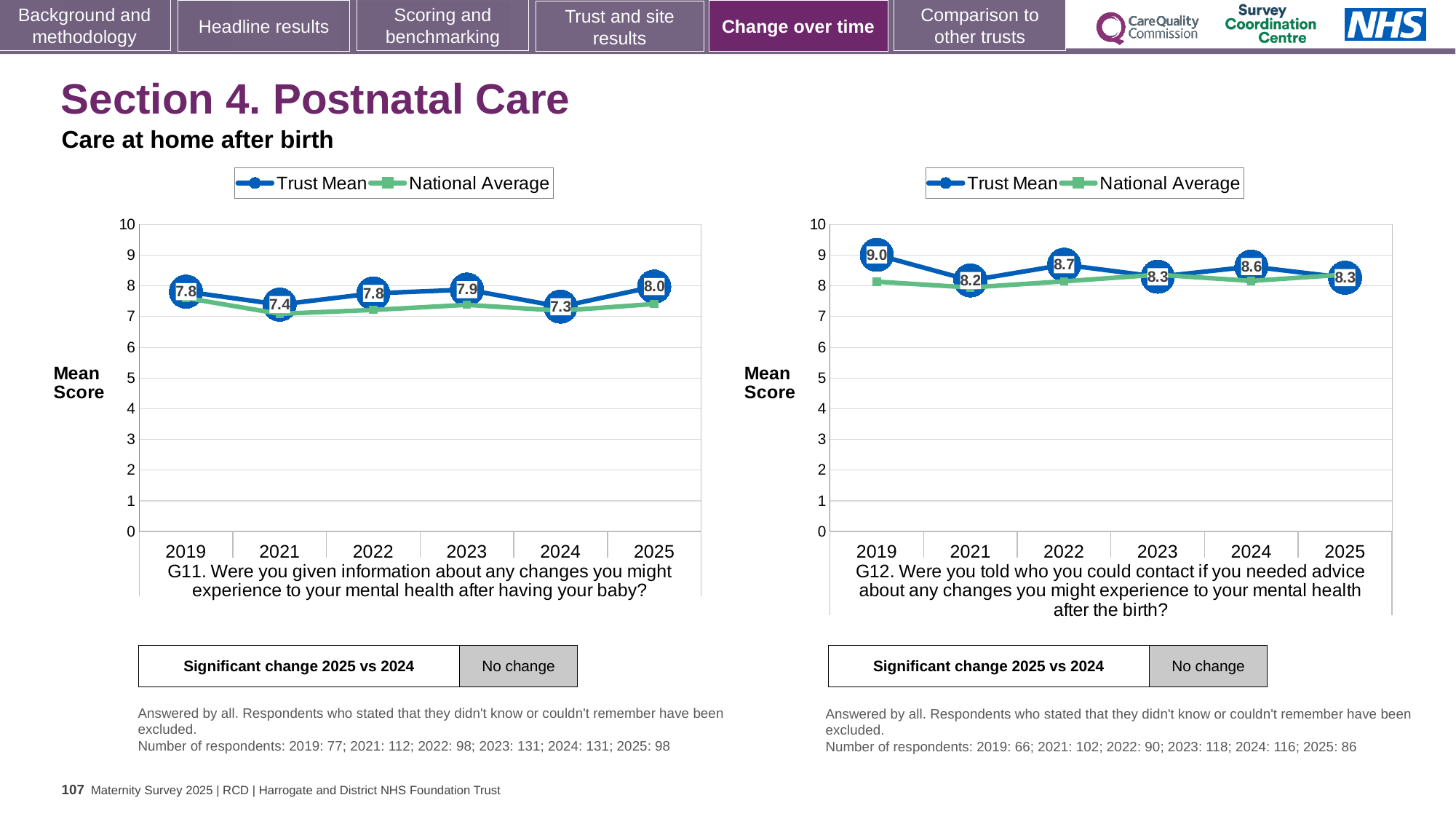
In the G12 chart on the right, is the National Average value for 2019 greater or less than 9? less In the G11 chart on the left, what is the Trust Mean score for 2024? 7.3 In the G12 chart on the right, what is the Trust Mean score for 2019? 9.0 What type of chart is the G11 chart on the left? Line chart In the G11 chart on the left, what is the Trust Mean score for 2025? 8.0 How many series does the legend of the G12 chart on the right list? 2 In the G11 chart on the left, what is the difference between the Trust Mean scores for 2025 and 2024? 0.7 In the G12 chart on the right, what is the Trust Mean score for 2022? 8.7 In the G12 chart on the right, which year has the lowest Trust Mean score? 2021 In the G11 chart on the left, which year has the highest Trust Mean score? 2025 How many years are plotted on the x axis of the G11 chart on the left? 6 In the G12 chart on the right, which is larger, the Trust Mean score for 2019 or for 2025? 2019